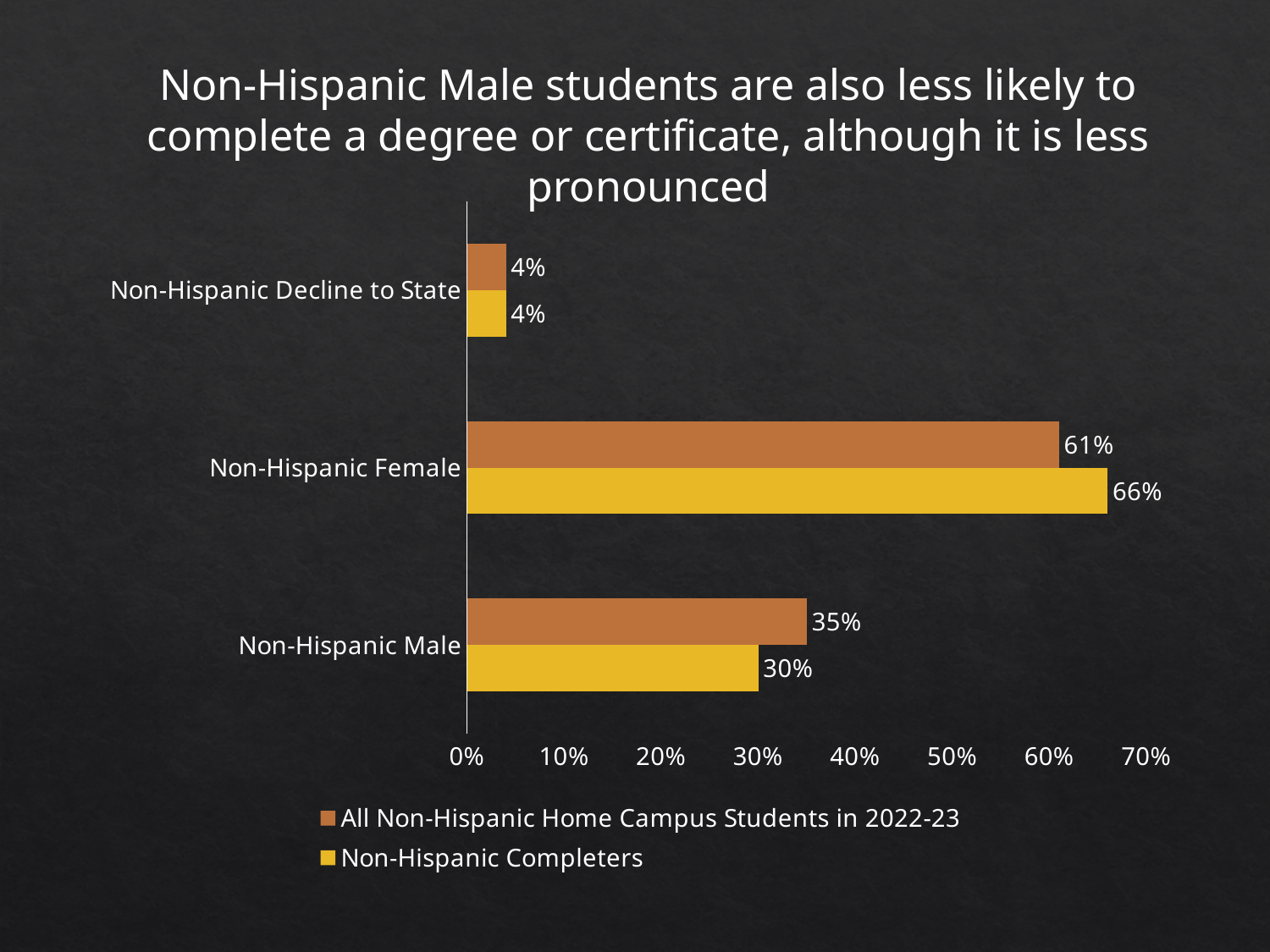
What is the value for Non-Hispanic Female in the Non-Hispanic Completers series? 66% For Non-Hispanic Male, which series has the larger value: All Non-Hispanic Home Campus Students in 2022-23 or Non-Hispanic Completers? All Non-Hispanic Home Campus Students in 2022-23 What is the difference between the Non-Hispanic Completers value and the All Non-Hispanic Home Campus Students in 2022-23 value for Non-Hispanic Female? 5% How many categories are shown on the chart? 3 Which category has the lowest value in the All Non-Hispanic Home Campus Students in 2022-23 series? Non-Hispanic Decline to State How many series does the legend list? 2 What kind of chart is shown on the slide? Bar chart What is the difference between the Non-Hispanic Completers value and the All Non-Hispanic Home Campus Students in 2022-23 value for Non-Hispanic Male? 5% Which category has the highest value in the Non-Hispanic Completers series? Non-Hispanic Female What is the value for Non-Hispanic Male in the All Non-Hispanic Home Campus Students in 2022-23 series? 35% What is the value for Non-Hispanic Decline to State in the Non-Hispanic Completers series? 4% Is the Non-Hispanic Completers value for Non-Hispanic Female greater or less than 60%? greater